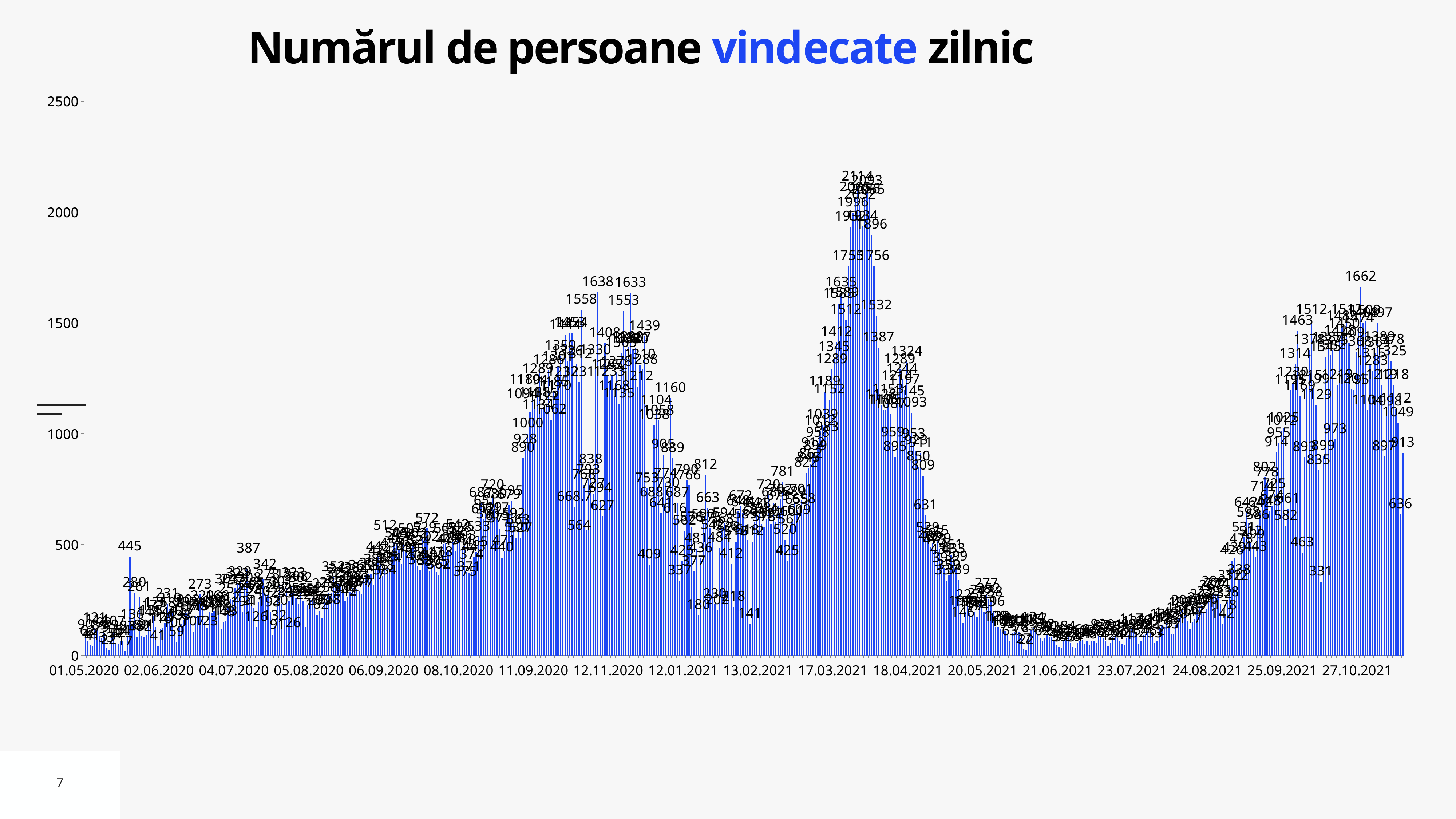
Do the values rise or fall along the x axis between 18.04.2021 and 21.06.2021? fall What is the first date label on the x axis? 01.05.2020 What is the difference between the overall peak value (2114) and the peak value after 25.09.2021 (1662)? 452 Which is larger: the peak value around 17.03.2021–18.04.2021 or the peak value around 11.09.2020–12.11.2020? the peak around 17.03.2021–18.04.2021 What is the title of the chart? Numărul de persoane vindecate zilnic What is the highest data label shown on the chart? 2114 What kind of chart is shown on the slide? bar chart Do the values rise or fall along the x axis between 24.08.2021 and 27.10.2021? rise What is the highest data label in the period after 25.09.2021? 1662 Is the highest value on the chart greater or less than 2000? greater Are the values around 21.06.2021 greater or less than 500? less What is the maximum value shown on the y axis? 2500